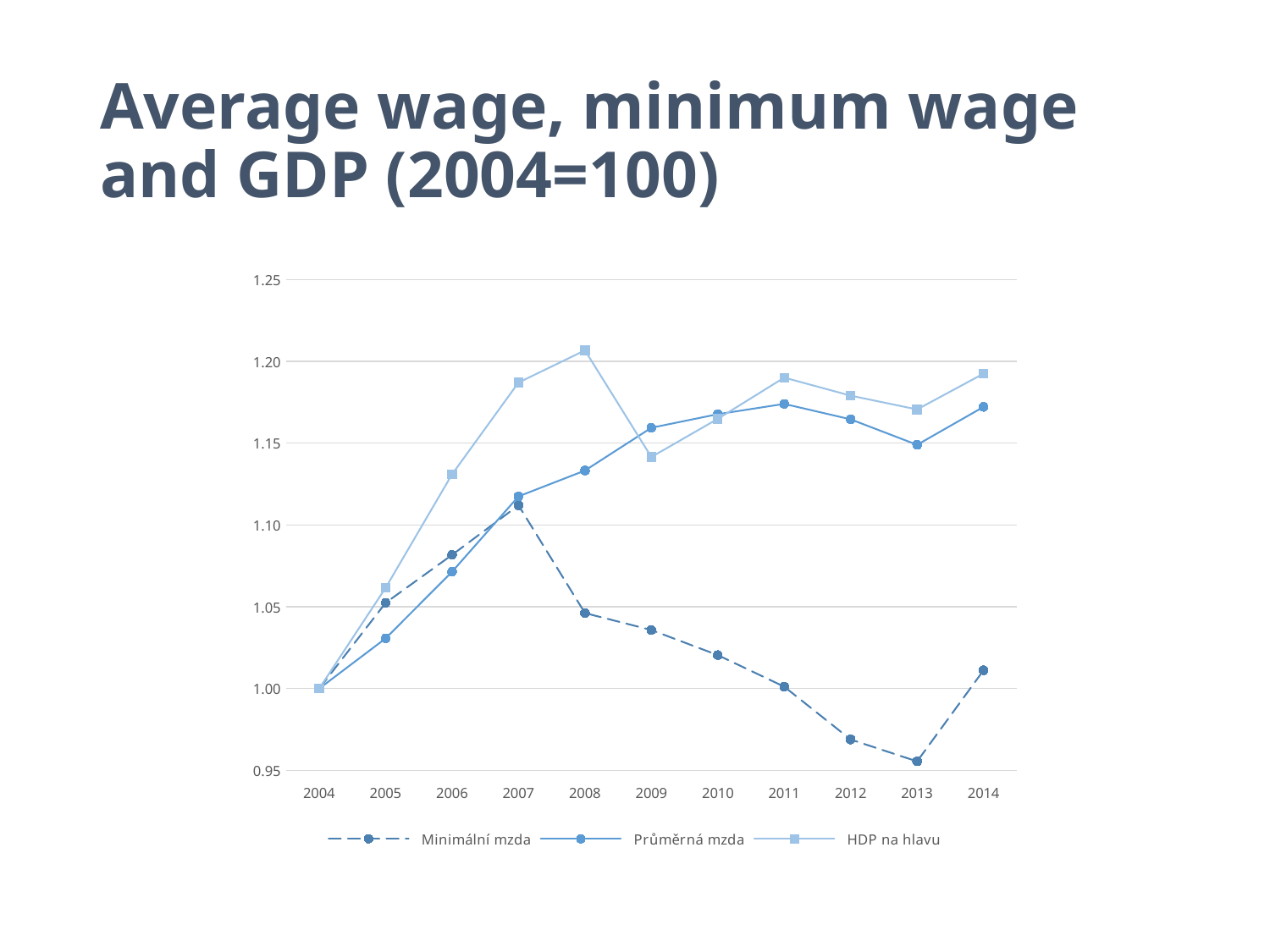
How many years are shown on the x axis? 11 In which year is Minimální mzda at its lowest? 2013 Does Minimální mzda rise or fall between 2007 and 2013? fall What is the title of the chart on the slide? Average wage, minimum wage and GDP (2004=100) Is the value for Průměrná mzda in 2011 greater or less than 1.15? greater What kind of chart is shown on the slide? line chart How many series does the legend list? 3 What is the value of Průměrná mzda in 2004? 1.00 In which year does HDP na hlavu reach its highest value? 2008 Is the value for HDP na hlavu in 2008 greater or less than 1.20? greater In 2009, which is higher: Průměrná mzda or HDP na hlavu? Průměrná mzda Is the value for Minimální mzda in 2013 greater or less than 1.00? less